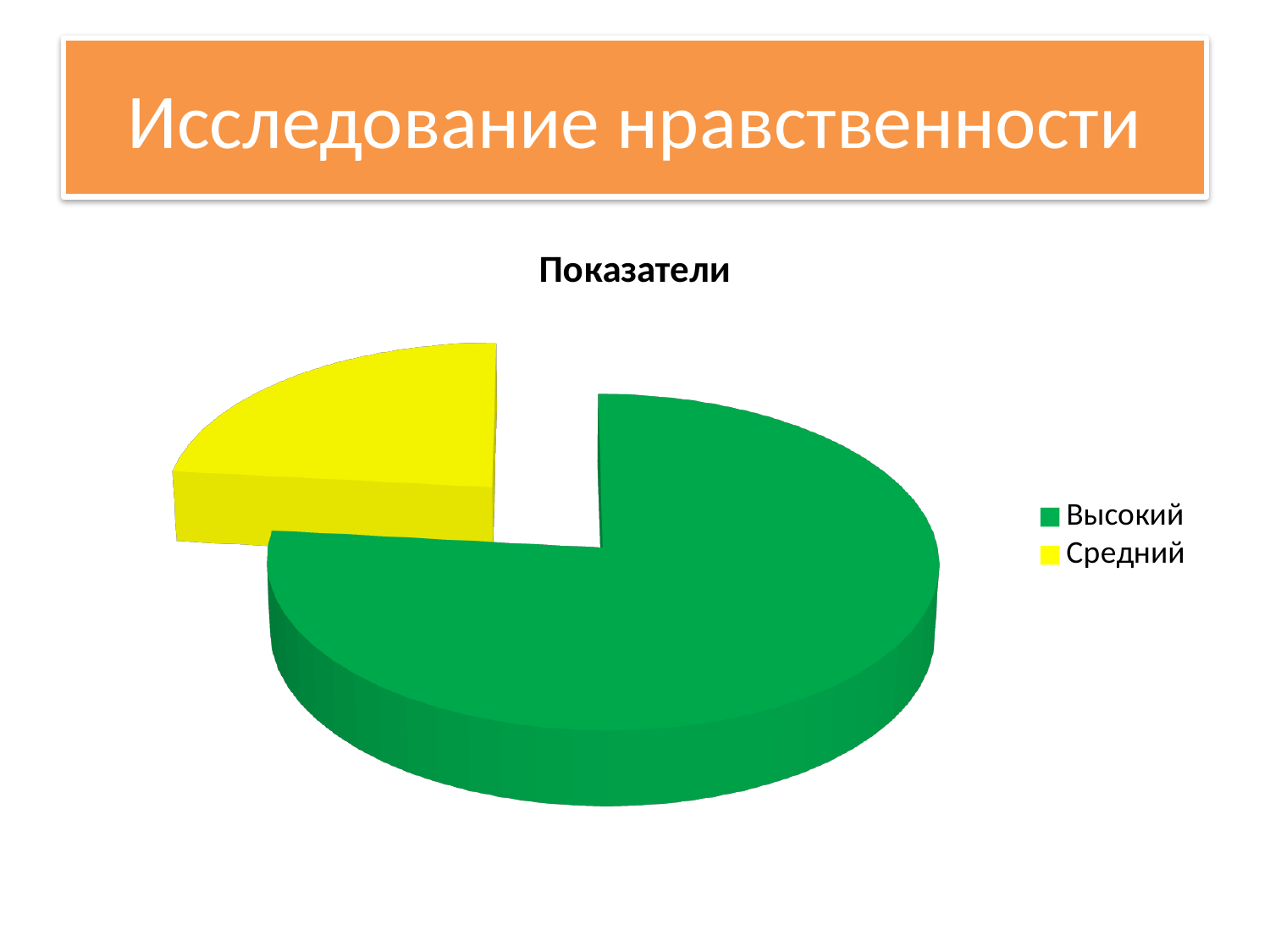
What kind of chart is shown on the slide? pie chart How many slices does the pie chart have? 2 How many entries does the legend list? 2 Which category has the largest slice of the pie? Высокий What colour is the slice for Средний? yellow Which category has the smallest slice of the pie? Средний Which slice is larger, Высокий or Средний? Высокий What is the title of the chart? Показатели